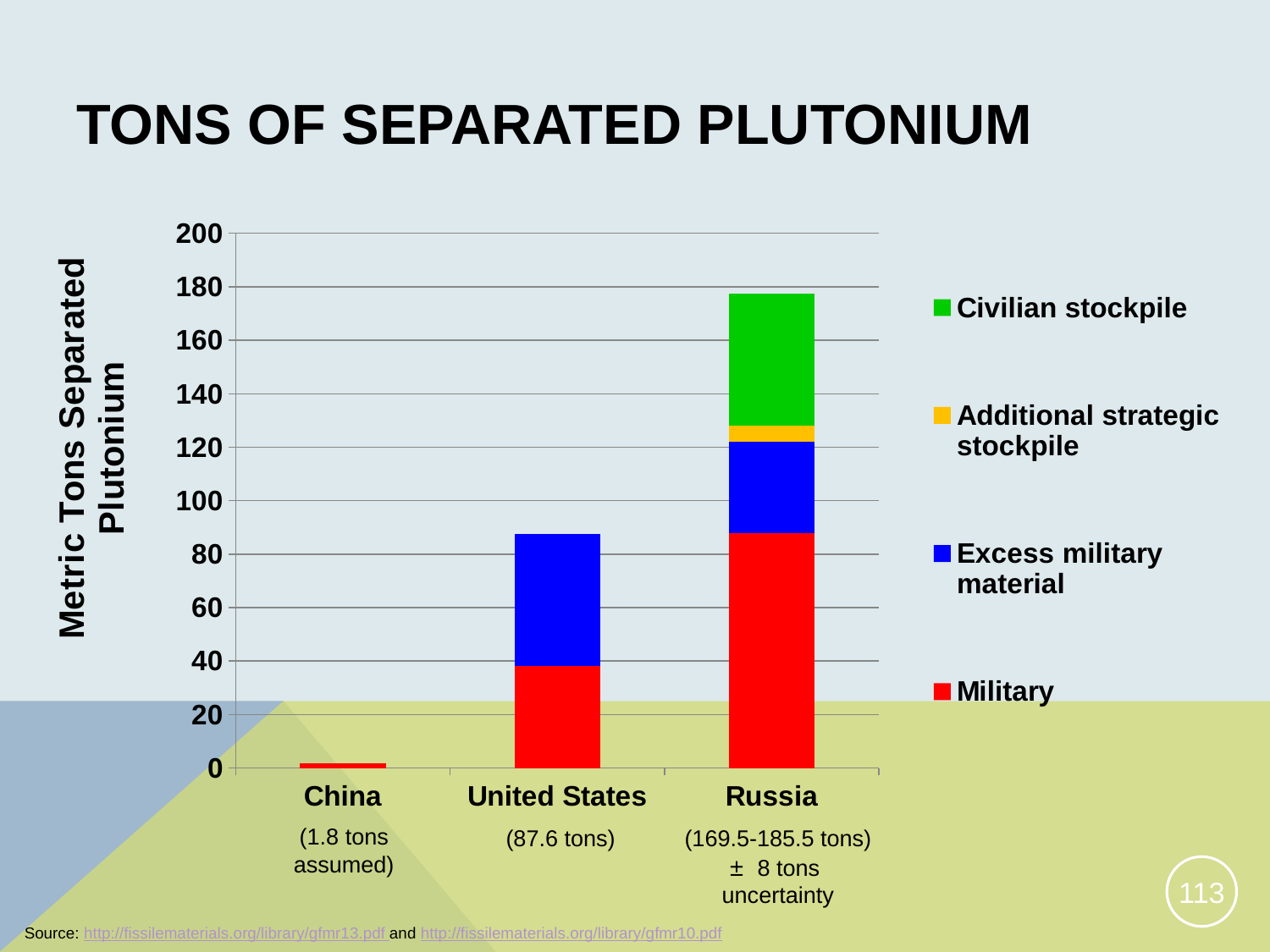
What type of chart is shown on the slide? Stacked bar chart Which country has the larger Military segment, the United States or Russia? Russia Do the stacked bar totals rise or fall moving from China to Russia along the x axis? Rise What range of tons is given for Russia in the annotation under the x axis? 169.5-185.5 tons How many series does the chart legend list? 4 How many countries are shown on the x axis of the chart? 3 According to the annotation under the x axis, how many tons of separated plutonium are assumed for China? 1.8 tons Is the total stacked bar for Russia greater or less than 160? greater Which country has the tallest stacked bar? Russia According to the annotation under the x axis, how many tons of separated plutonium does the United States have? 87.6 tons Which country has the shortest stacked bar? China